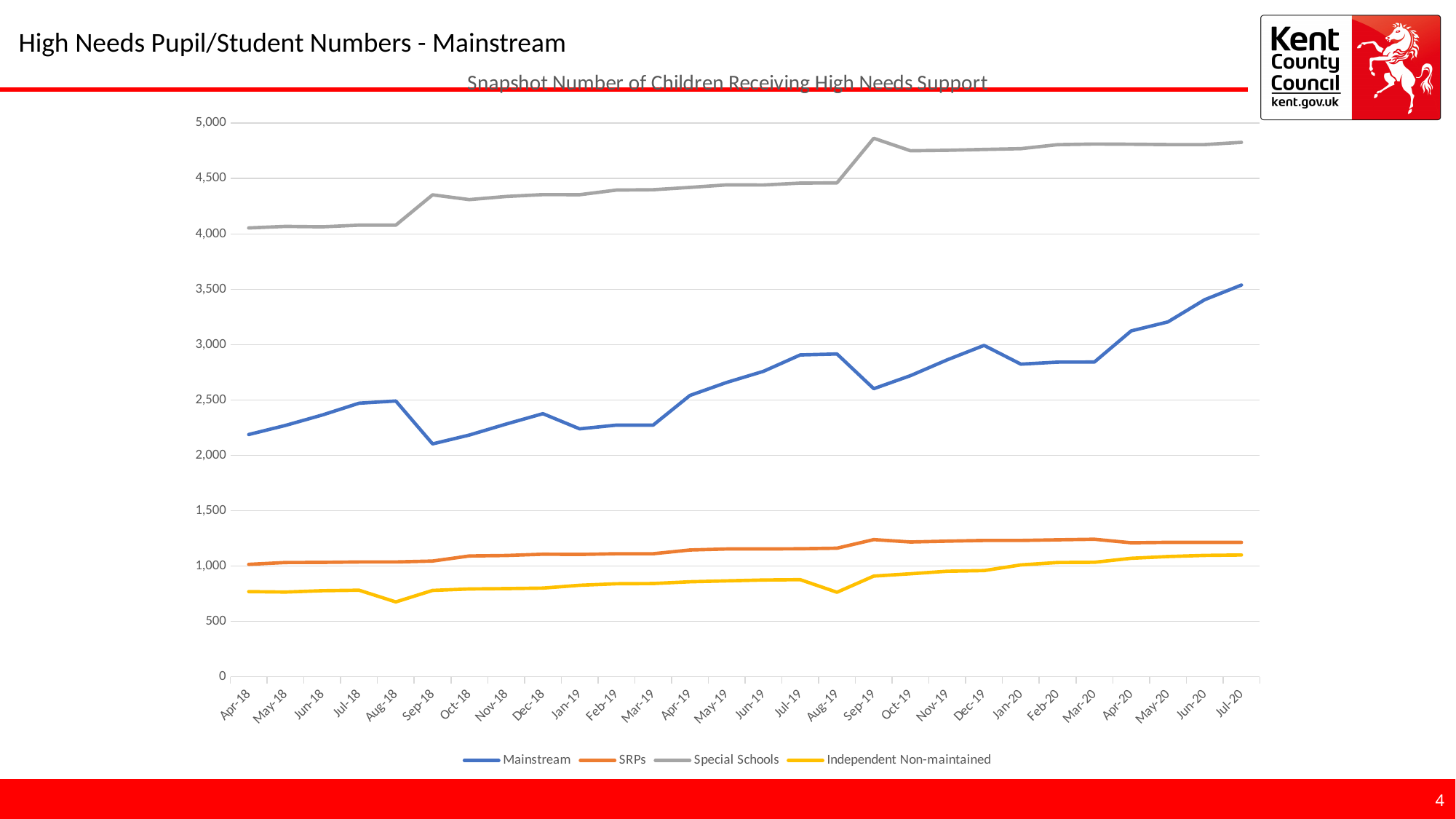
Is the value for Mainstream in Apr-18 greater or less than 2,500? less How many series does the legend list? 4 Is the value for SRPs in Jul-20 greater or less than 1,000? greater Which series has the highest values across the whole period? Special Schools How many months are shown along the x axis? 28 In Jul-20, which is larger: Special Schools or Mainstream? Special Schools What kind of chart is shown on the slide? line chart Is the value for Independent Non-maintained in Aug-18 greater or less than 1,000? less What is the title of the chart? Snapshot Number of Children Receiving High Needs Support Does the Special Schools line rise or fall overall from Apr-18 to Jul-20? rise Which series has the lowest values across the whole period? Independent Non-maintained